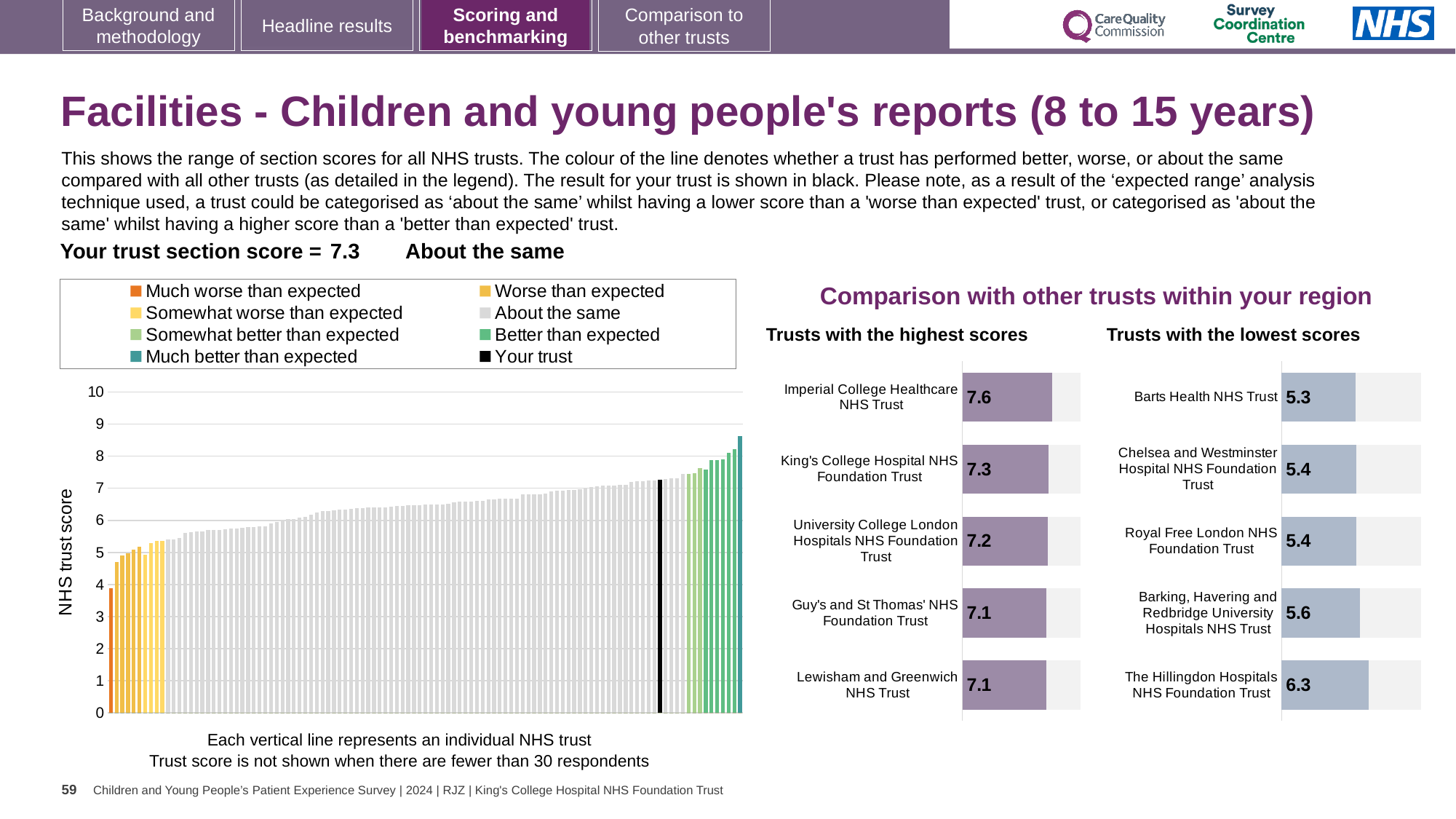
In the 'Trusts with the highest scores' chart, which trust has the highest score? Imperial College Healthcare NHS Trust How many trusts are shown in the 'Trusts with the lowest scores' chart? 5 In the 'Trusts with the lowest scores' chart, which has the larger score: Barking, Havering and Redbridge University Hospitals NHS Trust or The Hillingdon Hospitals NHS Foundation Trust? The Hillingdon Hospitals NHS Foundation Trust In the 'Trusts with the highest scores' chart, what is the score for Imperial College Healthcare NHS Trust? 7.6 In the 'Trusts with the highest scores' chart, what is the difference between the scores of Imperial College Healthcare NHS Trust and University College London Hospitals NHS Foundation Trust? 0.4 In the main 'NHS trust score' chart, is the value of the tallest bar greater or less than 8? greater In the 'Trusts with the lowest scores' chart, what is the score for The Hillingdon Hospitals NHS Foundation Trust? 6.3 In the main 'NHS trust score' chart, do the bar values rise or fall from left to right? Rise In the main 'NHS trust score' chart, what colour is used for 'Your trust'? Black What kind of chart is the main chart with the 'NHS trust score' axis? Bar chart How many entries does the legend of the main 'NHS trust score' chart list? 8 In the 'Trusts with the lowest scores' chart, which trust has the lowest score? Barts Health NHS Trust